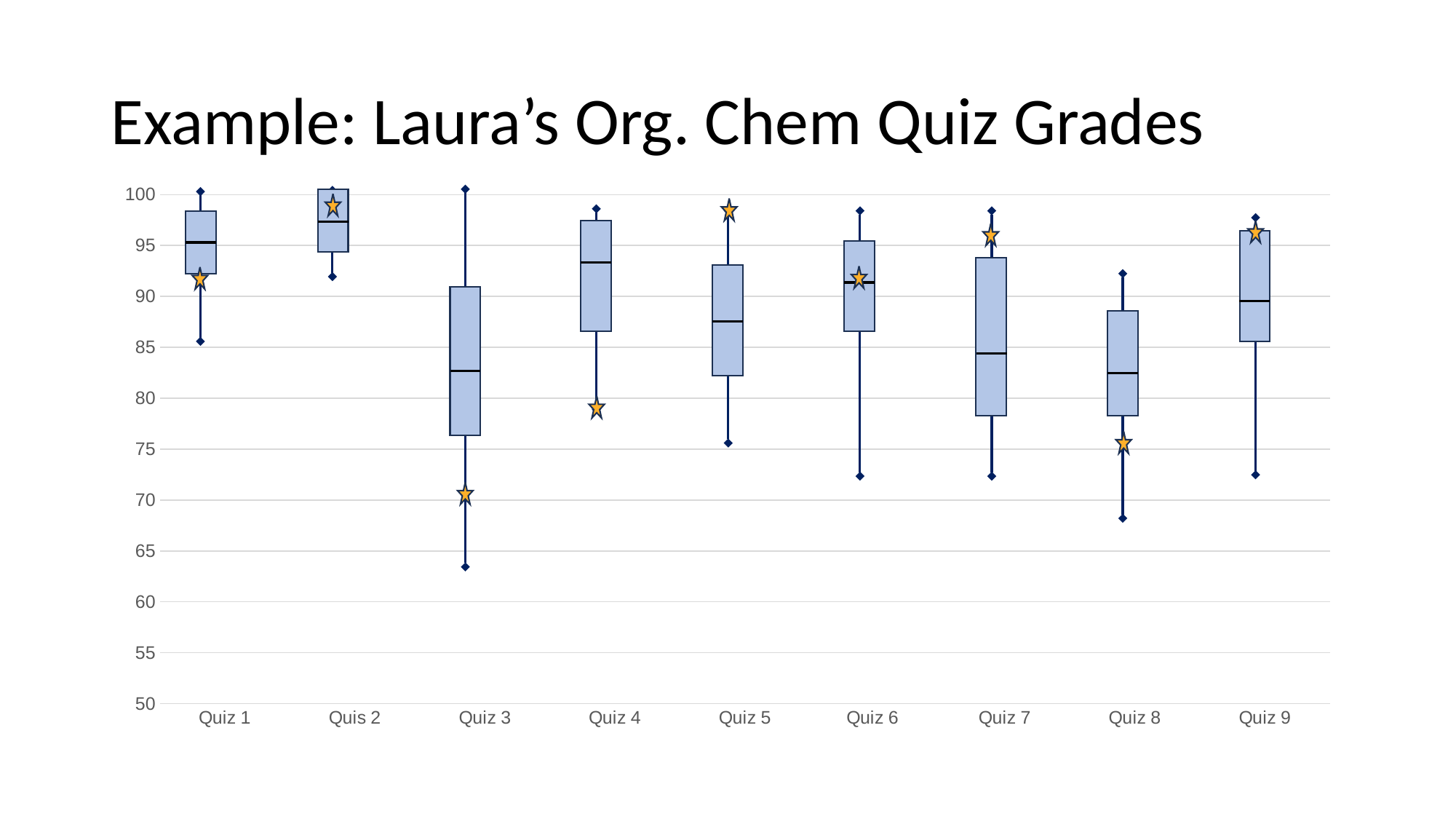
Which has the higher median line, Quiz 3 or Quiz 4? Quiz 4 Is the bottom whisker for Quiz 3 greater or less than 65? less Which quiz has the lowest bottom whisker value? Quiz 3 Is the star marker for Quiz 1 greater or less than 90? greater How many quizzes are plotted along the x axis? 9 Is the star marker for Quiz 4 greater or less than 80? less Which has the higher star marker, Quiz 4 or Quiz 5? Quiz 5 Which quiz has the lowest star marker? Quiz 3 What kind of chart is shown on the slide? Box-and-whisker plot What is the title of the slide containing the chart? Example: Laura's Org. Chem Quiz Grades Which quiz has the highest median line? Quis 2